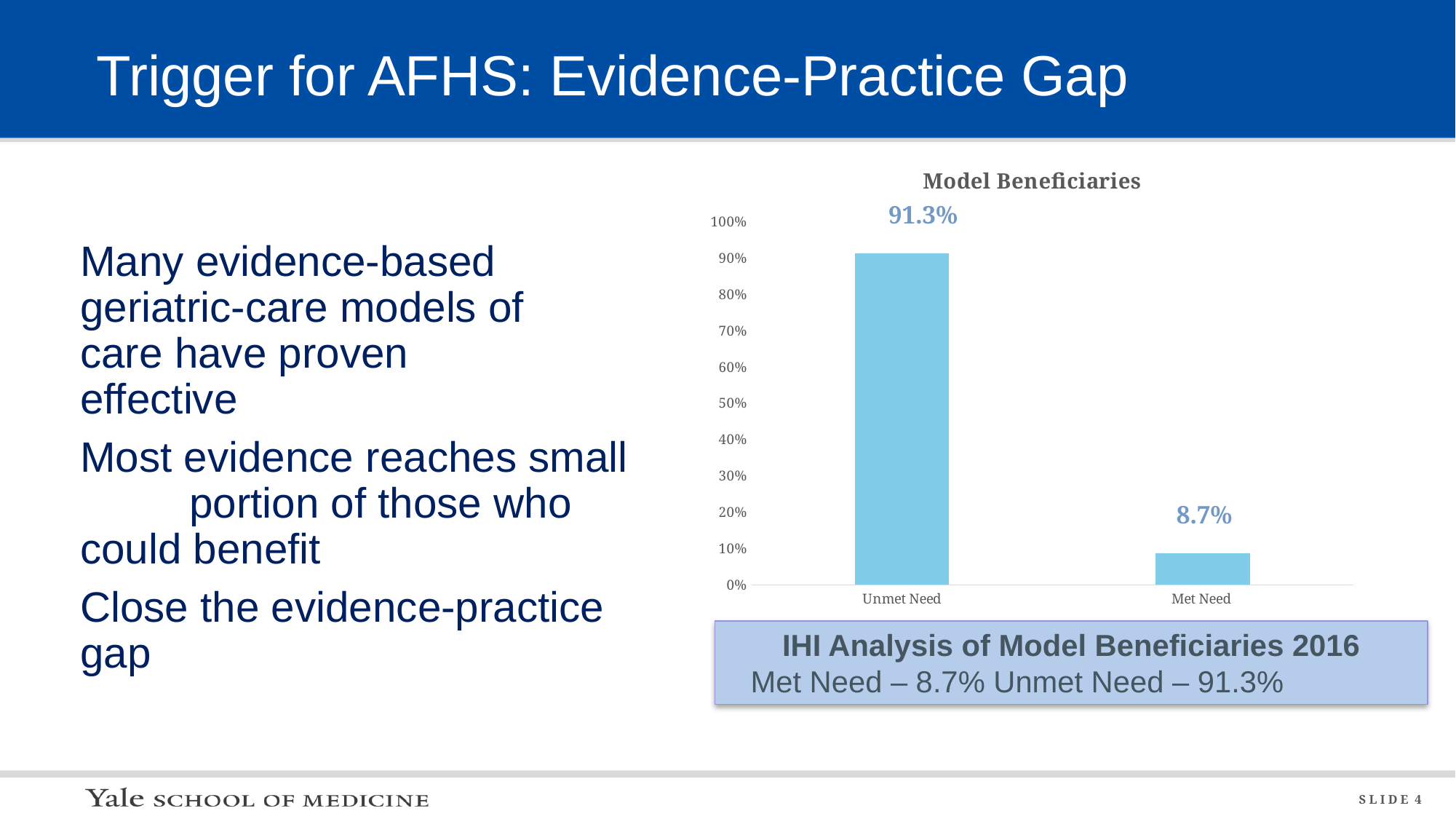
Is the value for Met Need greater or less than 10%? less What is the title of the chart on the slide? Model Beneficiaries What is the highest value shown on the y axis of the Model Beneficiaries chart? 100% What kind of chart is the Model Beneficiaries chart? bar chart How many categories are shown in the Model Beneficiaries chart? 2 What is the difference between the Unmet Need and Met Need values in the Model Beneficiaries chart? 82.6% What is the value for Unmet Need in the Model Beneficiaries chart? 91.3% Which category has the highest value in the Model Beneficiaries chart? Unmet Need Which category has the lowest value in the Model Beneficiaries chart? Met Need What is the value for Met Need in the Model Beneficiaries chart? 8.7% Is the value for Unmet Need greater or less than 90%? greater Which is larger in the Model Beneficiaries chart, Unmet Need or Met Need? Unmet Need